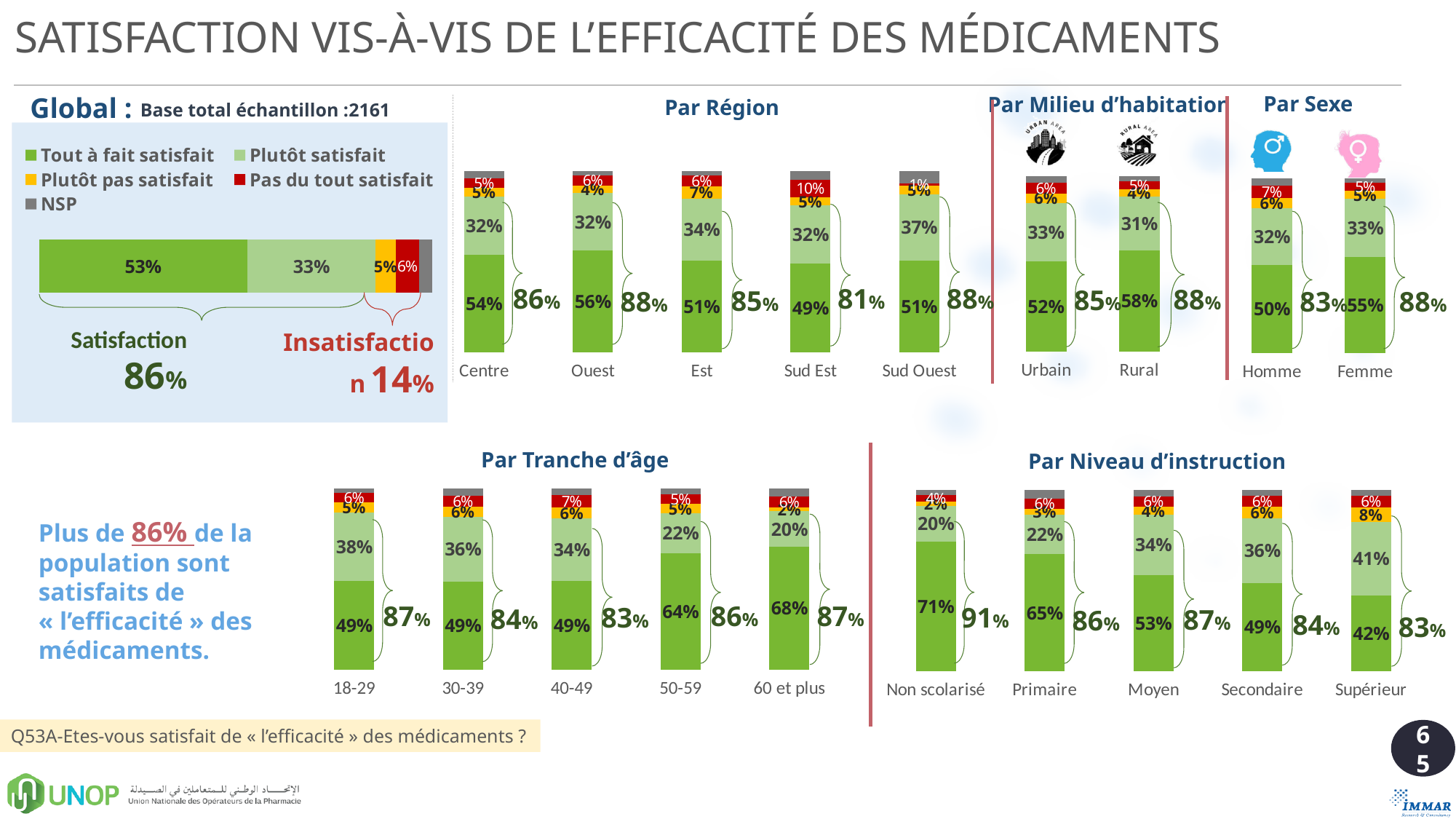
How many age groups are shown in the Par Tranche d'âge chart? 5 In the Par Région chart, what is the 'Tout à fait satisfait' value for Ouest? 56% In the Par Niveau d'instruction chart, which education level has the highest overall satisfaction? Non scolarisé How many series does the legend in the Global section list? 5 In the Par Milieu d'habitation chart, what is the difference between the overall satisfaction of Rural and Urbain? 3% In the Par Région chart, what is the 'Pas du tout satisfait' value for Sud Est? 10% In the Par Région chart, which region has the lowest overall satisfaction percentage? Sud Est In the Global chart, what percentage is 'Tout à fait satisfait'? 53% In the Par Sexe chart, which has the higher overall satisfaction, Homme or Femme? Femme In the Par Niveau d'instruction chart, what is the 'Plutôt satisfait' value for Supérieur? 41% In the Par Tranche d'âge chart, what is the 'Tout à fait satisfait' value for 60 et plus? 68% In the Global chart, what is the overall Satisfaction percentage shown? 86%